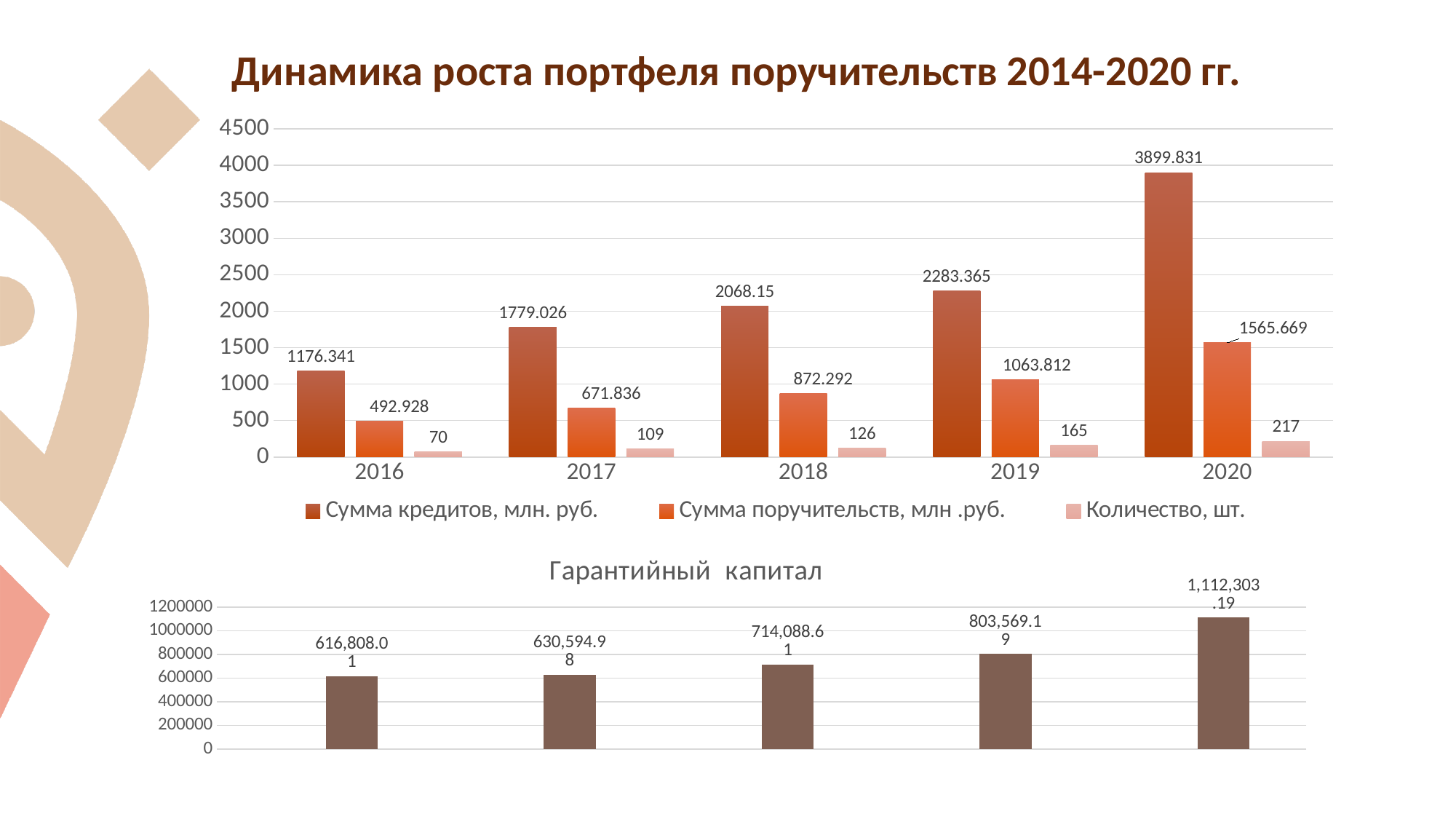
In the top chart, which year has the highest value for 'Сумма кредитов, млн. руб.'? 2020 In the top chart, how many series does the legend list? 3 In the top chart, is 'Сумма поручительств, млн .руб.' for 2019 greater or less than 1000? greater In the top chart, what is the value of 'Сумма поручительств, млн .руб.' for 2018? 872.292 In the 'Гарантийный капитал' chart, how many bars are plotted? 5 In the top chart, what is the difference between 'Сумма кредитов, млн. руб.' in 2020 and in 2019? 1616.466 What kind of chart is the 'Гарантийный капитал' chart at the bottom of the slide? bar chart In the top chart, what is the value of 'Сумма кредитов, млн. руб.' for 2020? 3899.831 In the top chart, what is the value of 'Количество, шт.' for 2016? 70 In the 'Гарантийный капитал' chart, what is the value of the last (rightmost) bar? 1,112,303.19 In the top chart, which year has the lowest value for 'Количество, шт.'? 2016 In the top chart, does 'Количество, шт.' rise or fall from 2016 to 2020? rise